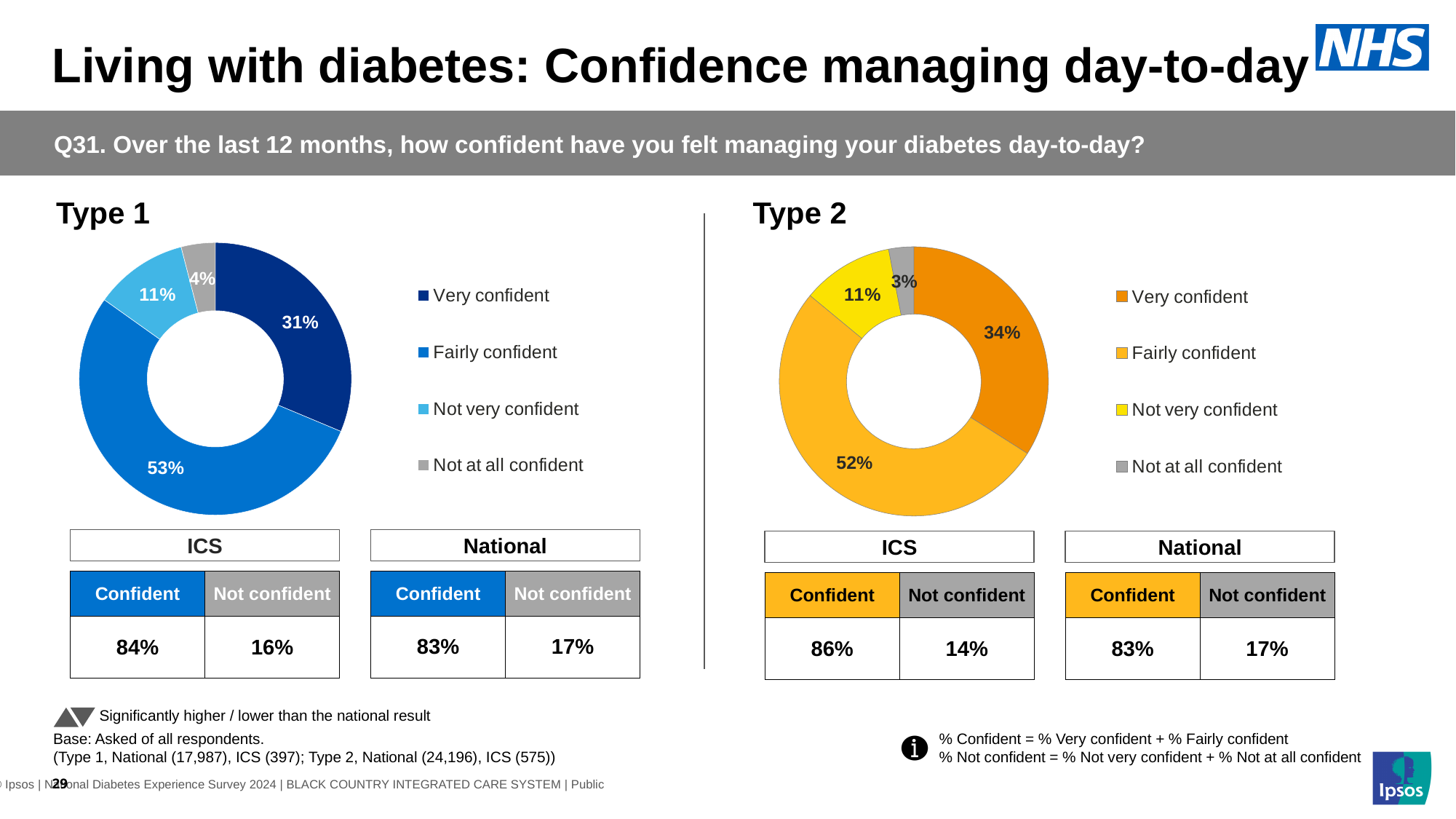
What kind of chart is used for Type 1? Doughnut (pie) chart In the Type 1 chart, what is the combined share of very confident and fairly confident? 84% Which is larger: the very confident share in the Type 1 chart or in the Type 2 chart? Type 2 In the Type 1 chart, what percentage were not at all confident? 4% In the Type 2 chart, what percentage were not very confident? 11% In the Type 1 chart, what percentage of respondents were very confident? 31% How many categories does the Type 2 chart's legend list? 4 In the Type 1 chart, what is the difference between the fairly confident and very confident shares? 22 percentage points In the Type 2 chart, which category has the smallest share? Not at all confident In the Type 2 chart, what percentage of respondents were fairly confident? 52% In the Type 2 chart, what colour represents the fairly confident category? Orange/yellow-orange In the Type 1 chart, which category has the largest share? Fairly confident